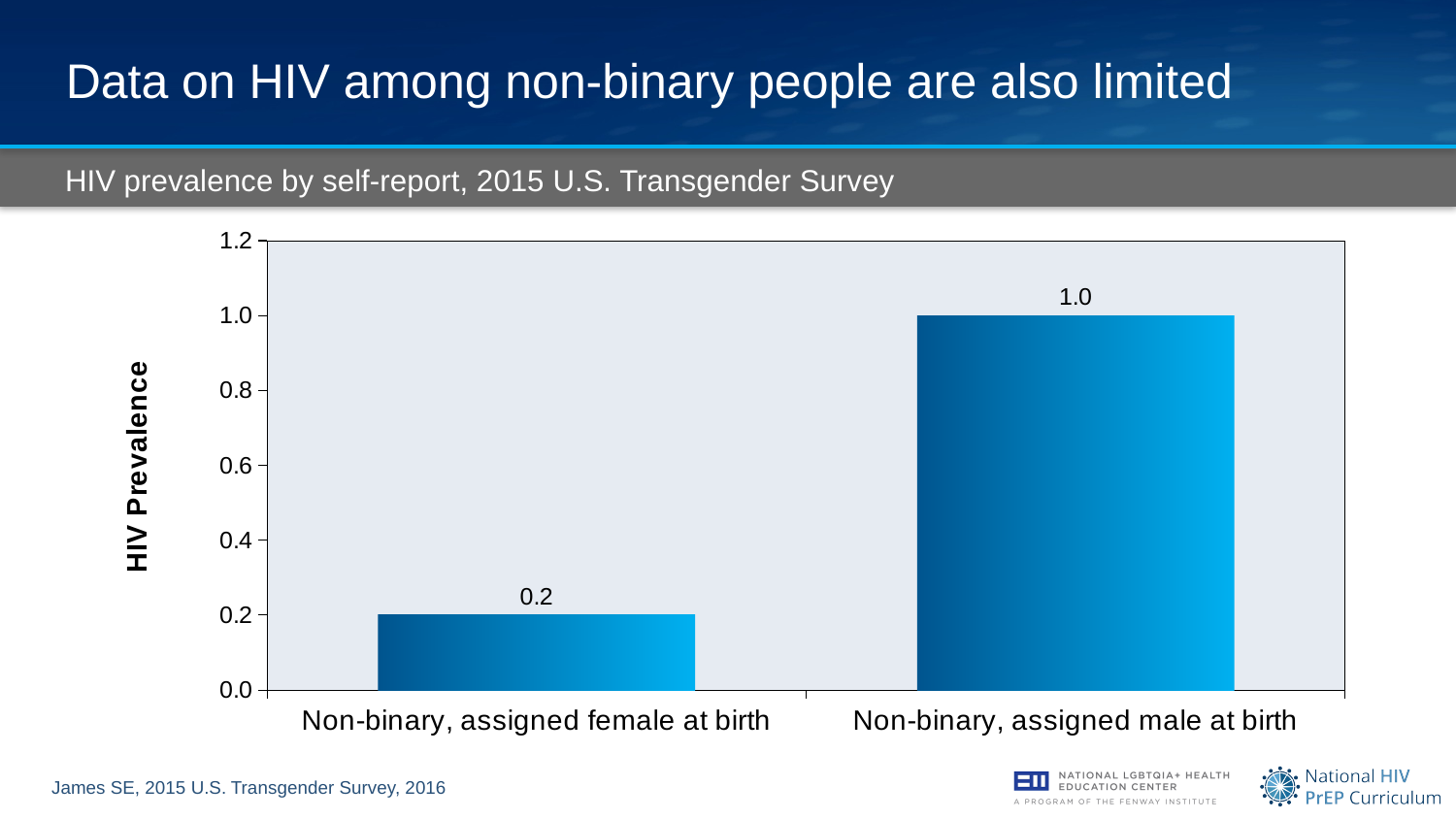
Is the value for non-binary, assigned female at birth greater or less than 0.4? less Is the value for non-binary, assigned male at birth greater or less than 0.6? greater What is the title of the chart? HIV prevalence by self-report, 2015 U.S. Transgender Survey Which is larger: the HIV prevalence for non-binary, assigned female at birth or for non-binary, assigned male at birth? Non-binary, assigned male at birth What is the difference in HIV prevalence between non-binary, assigned male at birth and non-binary, assigned female at birth? 0.8 What kind of chart is shown on the slide? Bar chart What is the HIV prevalence value for non-binary, assigned female at birth? 0.2 What is the label on the vertical axis of the chart? HIV Prevalence What is the HIV prevalence value for non-binary, assigned male at birth? 1.0 Which category has the lowest HIV prevalence? Non-binary, assigned female at birth Which category has the highest HIV prevalence? Non-binary, assigned male at birth How many categories are shown on the chart? 2